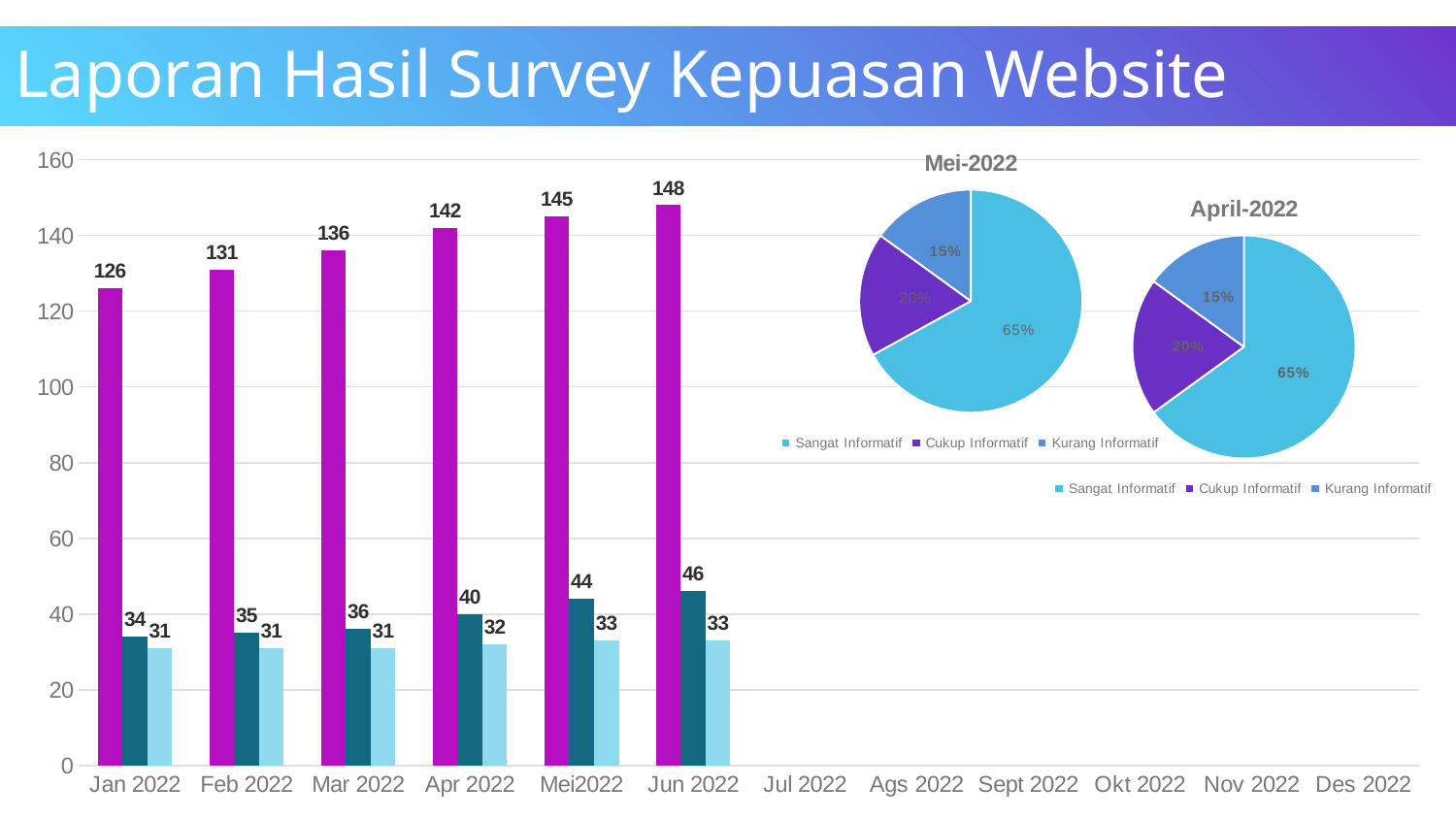
In the bar chart on the left, how many months have bars plotted? 6 How many entries does the legend of the April-2022 pie chart list? 3 In the bar chart on the left, which month has the highest magenta bar? Jun 2022 In the Mei-2022 pie chart, what share does Sangat Informatif have? 65% In the bar chart on the left, which month has the lowest magenta bar? Jan 2022 What kind of chart is the chart on the left of the slide? bar chart In the bar chart on the left, do the magenta bar values rise or fall from Jan 2022 to Jun 2022? rise In the bar chart on the left, is the dark teal bar for Mei2022 larger or smaller than the dark teal bar for Feb 2022? larger In the bar chart on the left, what is the value of the light blue bar for Jun 2022? 33 In the bar chart on the left, what is the value of the tallest (magenta) bar for Jan 2022? 126 In the bar chart on the left, what is the value of the dark teal bar for Apr 2022? 40 In the bar chart on the left, what is the difference between the magenta bar values for Jun 2022 and Jan 2022? 22